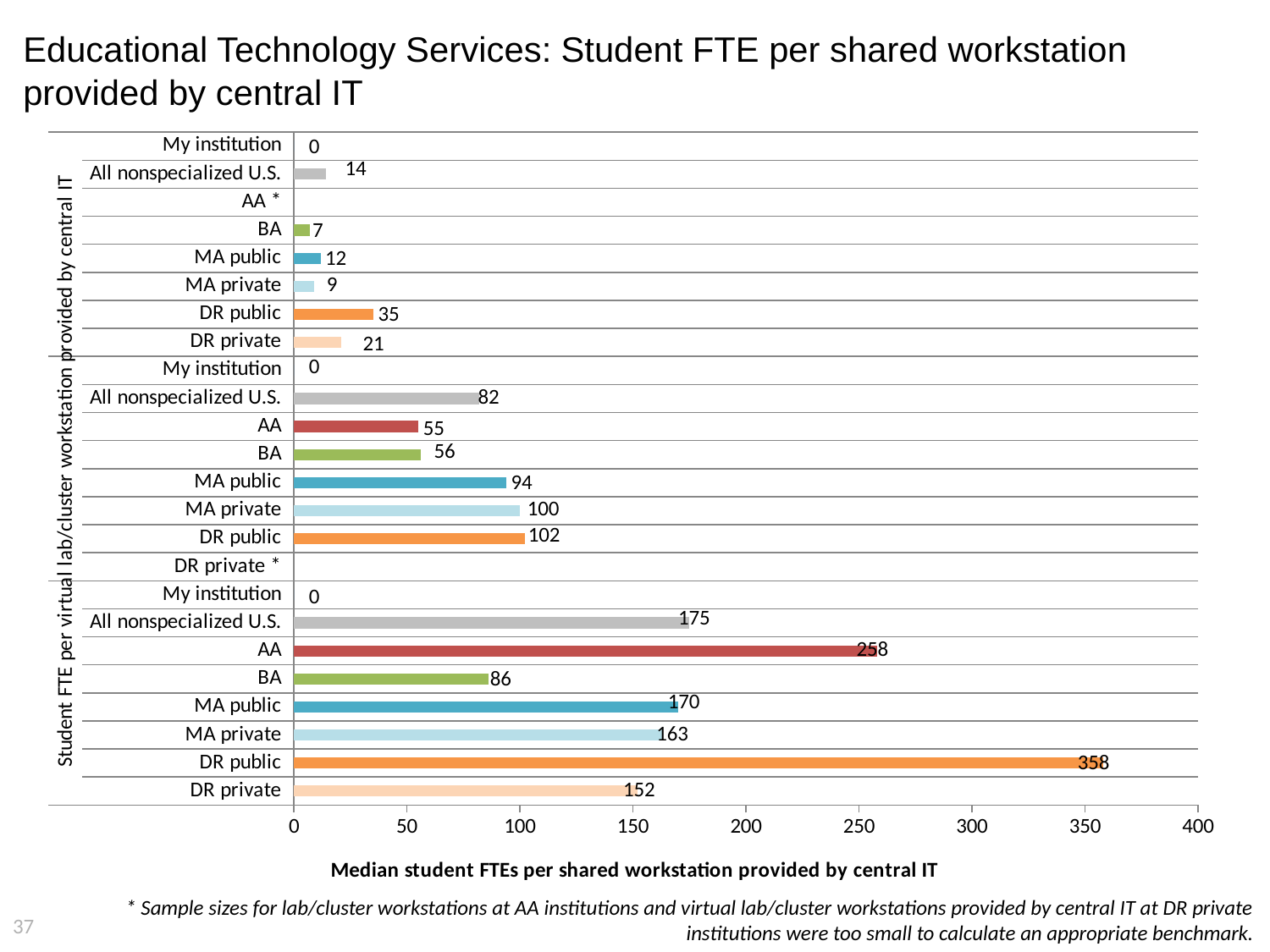
In the middle group, which category has the highest value? DR public Which category has the highest value on the whole chart? DR public (bottom group) What is the label of the horizontal axis of the chart? Median student FTEs per shared workstation provided by central IT Is the value for AA in the bottom group greater or less than 250? greater What is the value for DR public in the bottom group of the chart? 358 What is the value for MA private in the middle group of the chart? 100 What is the value for AA in the bottom group of the chart? 258 What is the value for All nonspecialized U.S. in the top group of the chart? 14 In the bottom group, which is larger: All nonspecialized U.S. or MA public? All nonspecialized U.S. What is the difference between DR public and DR private in the bottom group? 206 What is the difference between MA public and MA private in the bottom group? 7 What kind of chart is shown on the slide? Bar chart